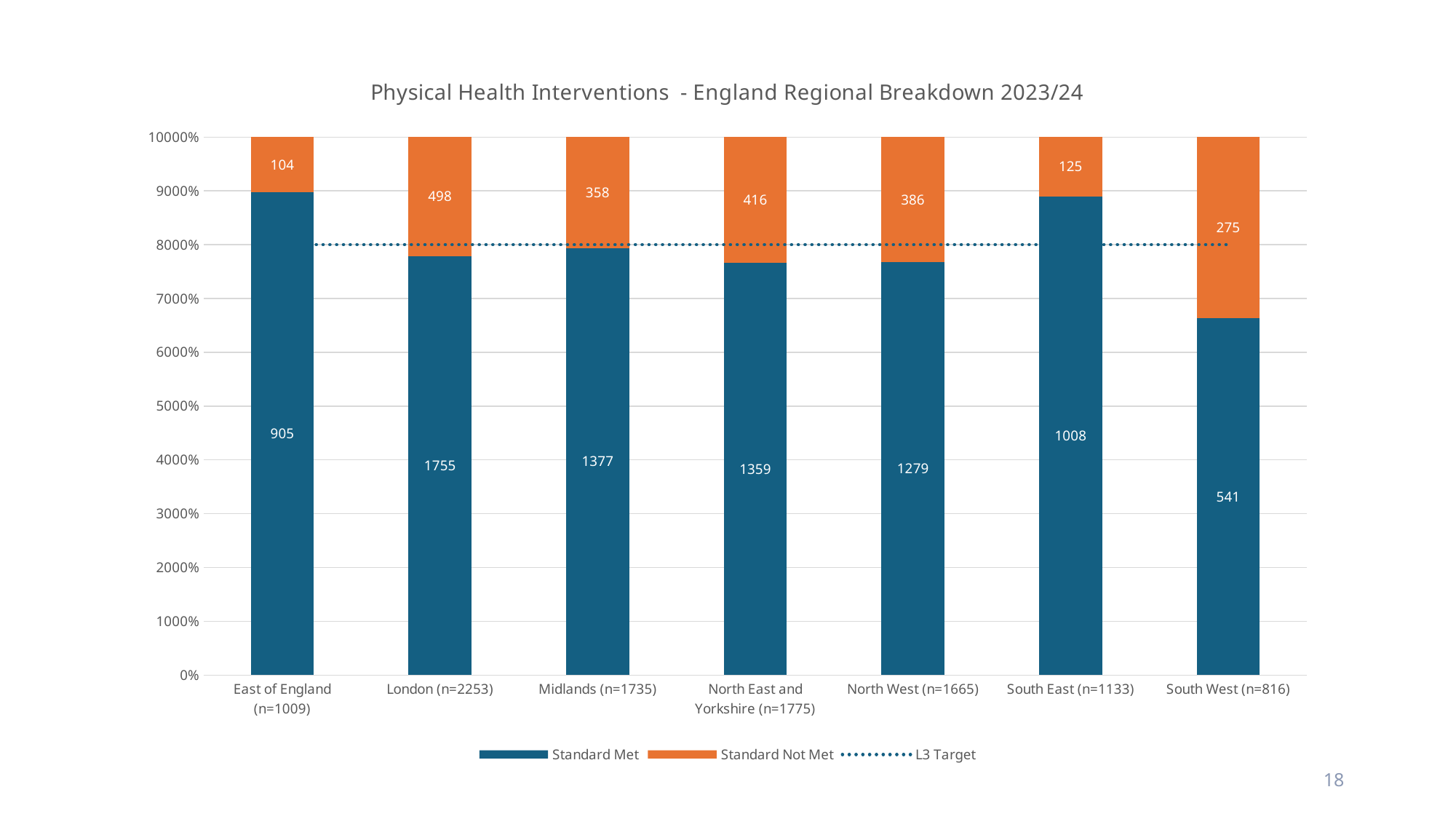
What is the total of the Standard Met and Standard Not Met values for East of England (n=1009)? 1009 Which is larger, the Standard Not Met value for Midlands (n=1735) or for North West (n=1665)? North West (n=1665) What is the Standard Met value for London (n=2253)? 1755 How many entries does the legend list? 3 What is the difference between the Standard Met and Standard Not Met values for London (n=2253)? 1257 What kind of chart is shown on the slide? Stacked bar chart What is the Standard Not Met value for South West (n=816)? 275 Is the top of the Standard Met segment for South West (n=816) greater or less than 7000%? less What is the Standard Met value for North East and Yorkshire (n=1775)? 1359 How many regions are shown on the x axis? 7 Which region has the lowest Standard Not Met value? East of England (n=1009)